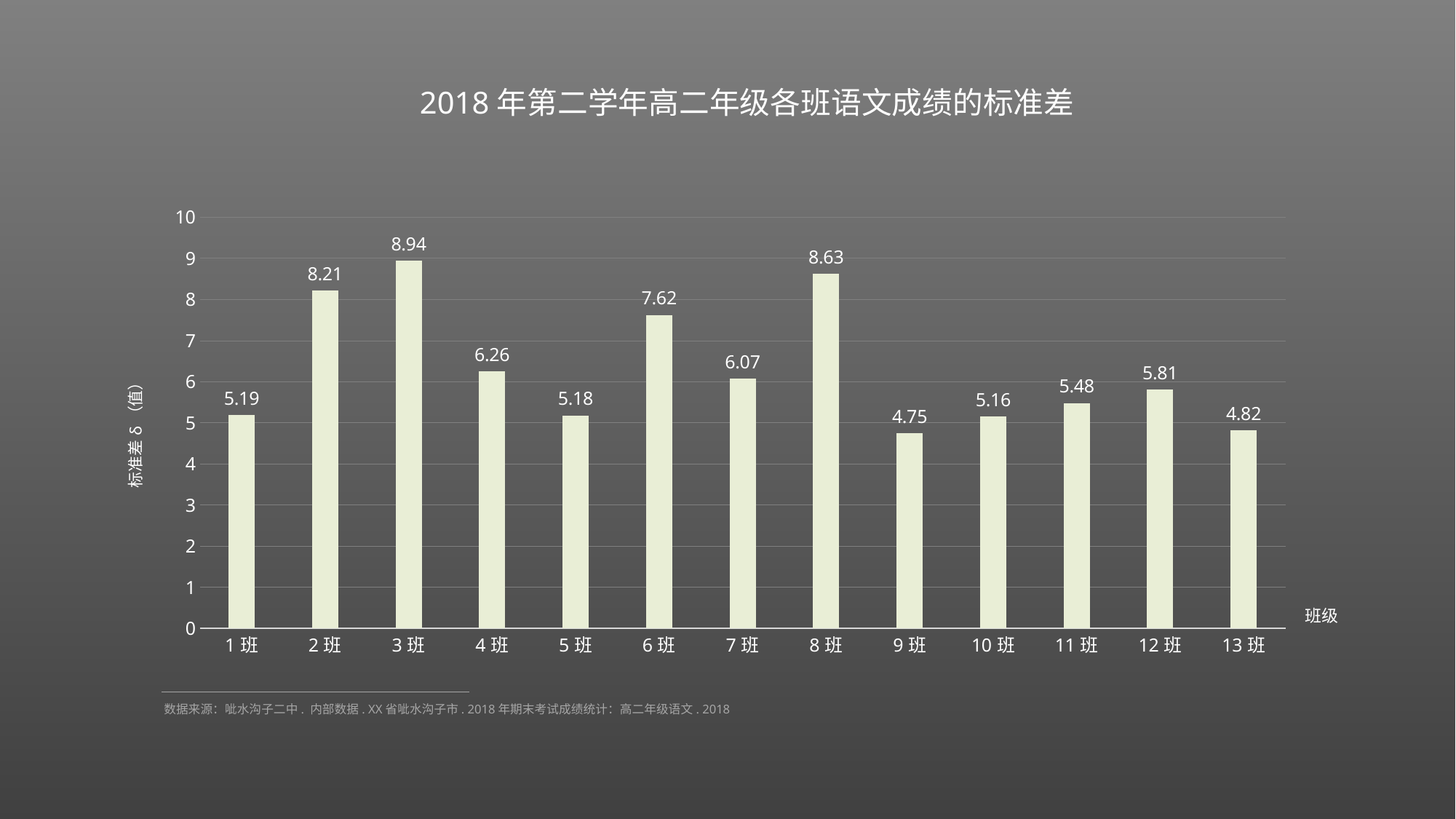
Which has a larger value, 6 班 or 8 班? 8 班 How many classes are shown on the x axis? 13 Is the value for 4 班 greater or less than 6? greater What is the value shown for 13 班? 4.82 What is the difference between the values for 3 班 and 9 班? 4.19 What is the standard deviation value for 3 班? 8.94 What kind of chart is shown on the slide? bar chart What is the title of the chart? 2018 年第二学年高二年级各班语文成绩的标准差 What is the value shown for 10 班? 5.16 What is the difference between the values for 2 班 and 1 班? 3.02 Which class has the lowest standard deviation? 9 班 Which class has the highest standard deviation? 3 班